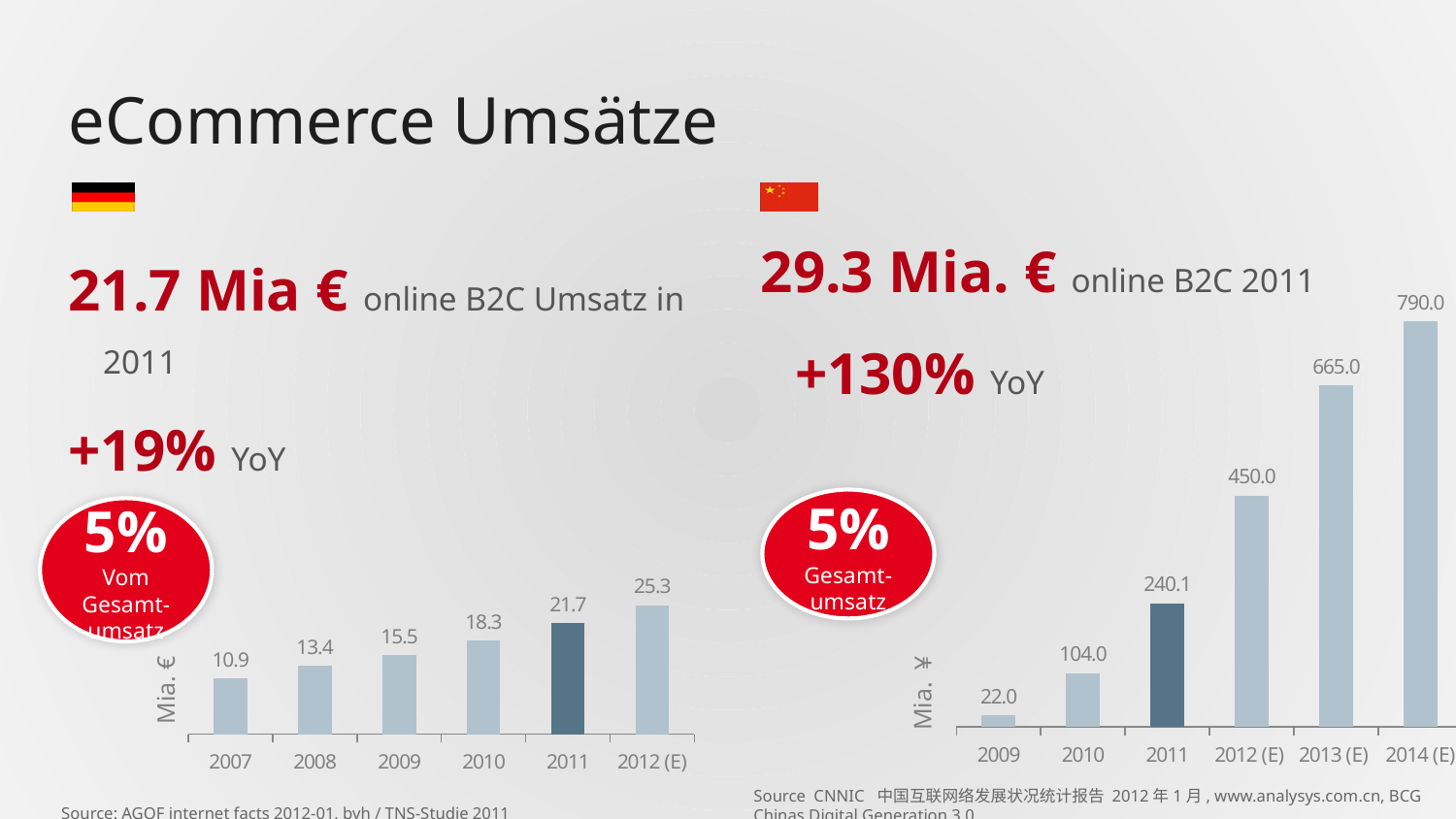
In the right chart, what is the difference between the values for 2012 (E) and 2011? 209.9 In the left chart, what is the value for 2012 (E)? 25.3 In the right chart, which year has the highest value? 2014 (E) In the right chart, what is the value for 2011? 240.1 In the right chart, which is larger, the value for 2010 or the value for 2009? 2010 In the left chart, what is the difference between the values for 2011 and 2010? 3.4 In the left chart, which year has the lowest value? 2007 Do the values in the right chart rise or fall from 2009 to 2014 (E)? rise How many bars are shown in the left chart? 6 What type of chart is the left chart? bar chart In the right chart, what is the value for 2013 (E)? 665.0 In the left chart, what is the value for 2009? 15.5